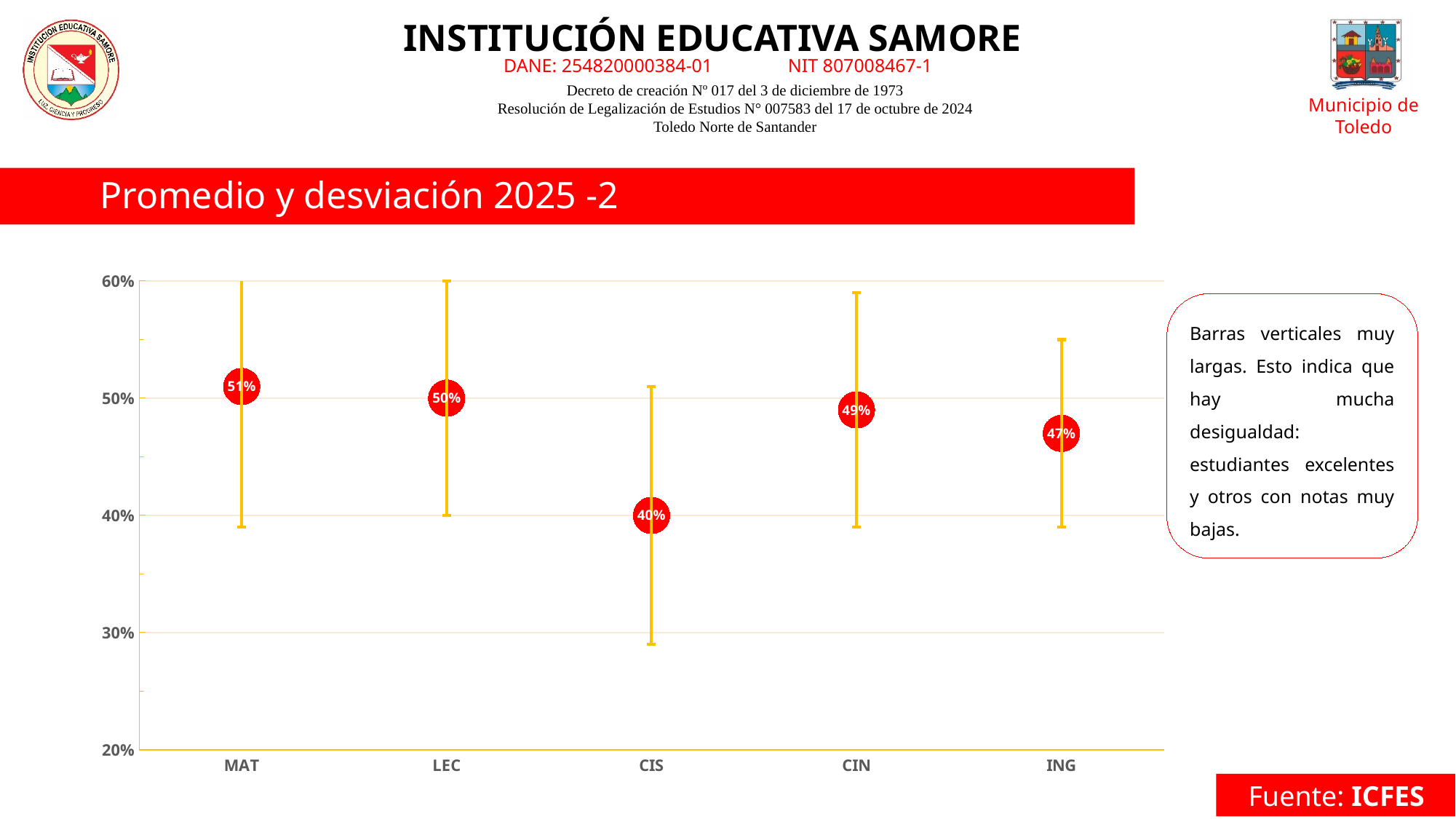
What is the value for MAT? 51% What is the value for CIN? 49% Which category has the highest value? MAT Is the value for CIS greater or less than 50%? less What is the difference between the values for LEC and ING? 3% Which is larger, the value for CIN or the value for ING? CIN What is the difference between the values for MAT and CIS? 11% How many categories are shown on the x axis? 5 What is the value for CIS? 40% What is the value for ING? 47% Which category has the lowest value? CIS What is the title of the slide section containing the chart? Promedio y desviación 2025 -2